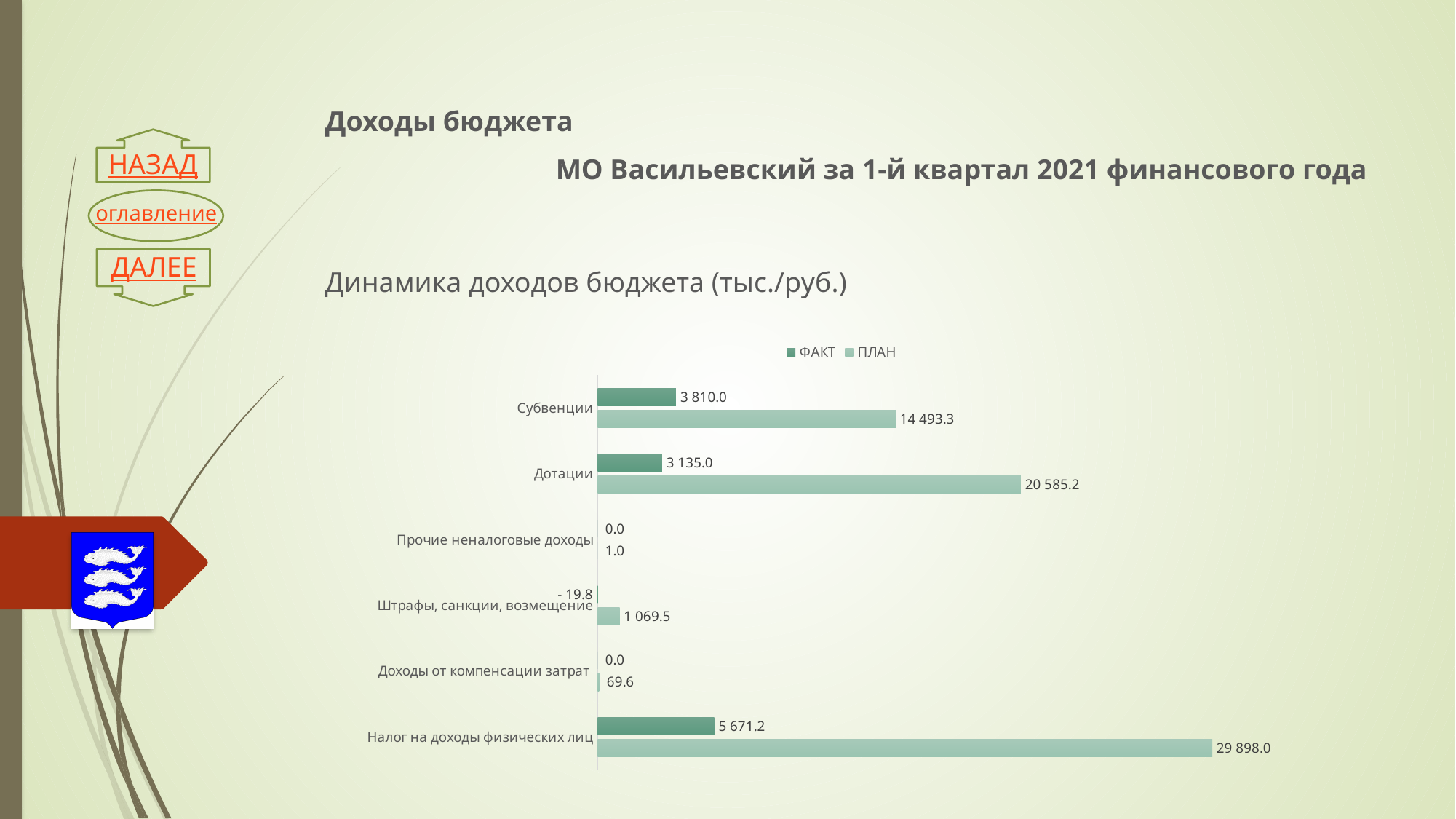
What kind of chart is shown on the slide? Bar chart Which category has the highest ПЛАН value? Налог на доходы физических лиц What is the difference between the ПЛАН and ФАКТ values for Налог на доходы физических лиц? 24 226.8 How many series does the legend list? 2 What is the ФАКТ value for Субвенции? 3 810.0 Which category has the lowest ФАКТ value? Штрафы, санкции, возмещение What is the ПЛАН value for Штрафы, санкции, возмещение? 1 069.5 What is the ФАКТ value for Штрафы, санкции, возмещение? - 19.8 What is the ПЛАН value for Доходы от компенсации затрат? 69.6 What is the ПЛАН value for Дотации? 20 585.2 How many categories are shown on the chart? 6 Which is larger: the ФАКТ value for Субвенции or the ФАКТ value for Дотации? Субвенции